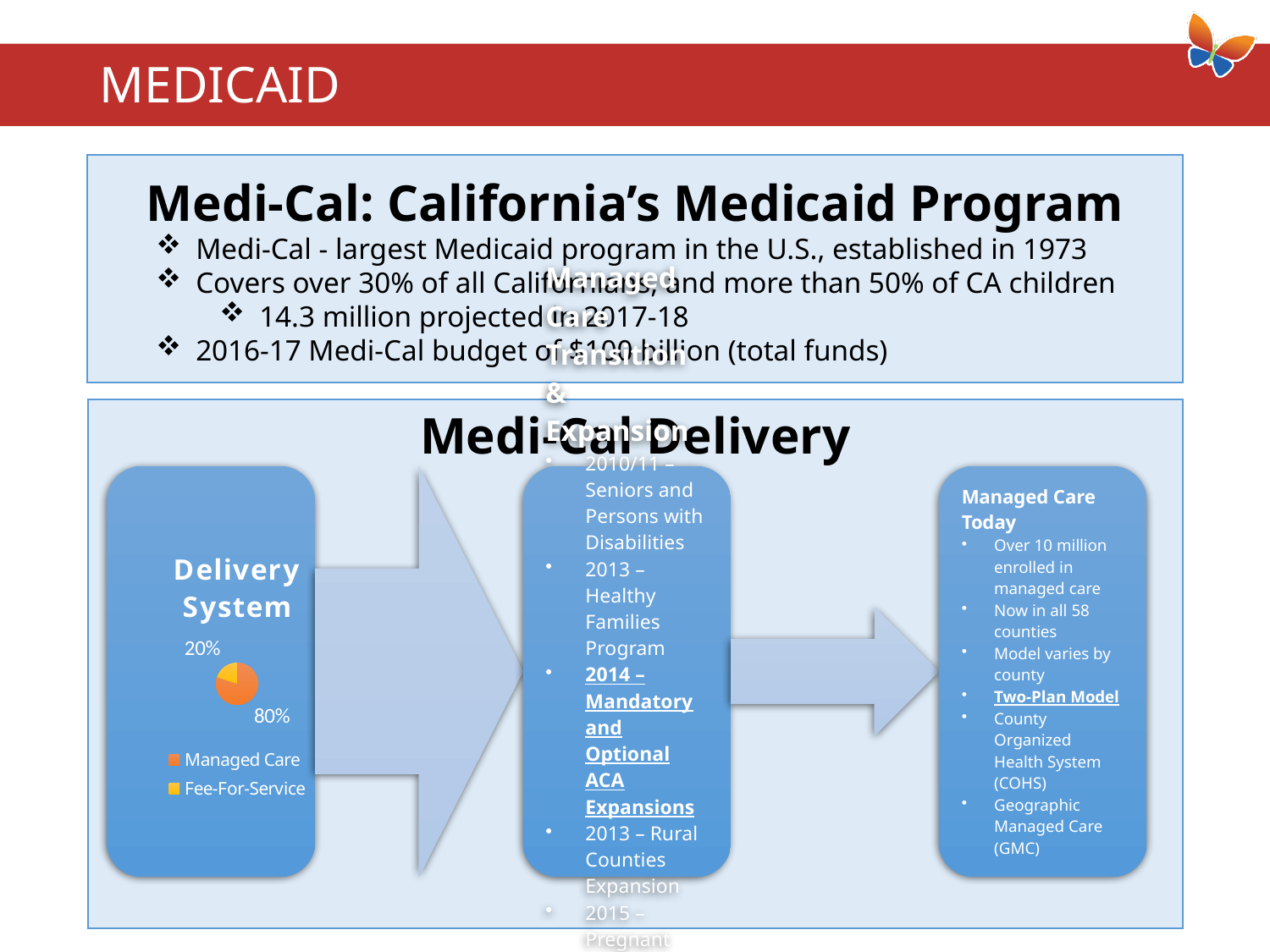
In the Delivery System pie chart, what share is Managed Care? 80% How many entries does the legend of the Delivery System pie chart list? 2 How many slices does the Delivery System pie chart have? 2 In the Delivery System pie chart, which legend entry is shown in orange? Managed Care In the Delivery System pie chart, which is larger: Managed Care or Fee-For-Service? Managed Care What kind of chart is the Delivery System chart? pie chart In the Delivery System pie chart, what share is Fee-For-Service? 20% Which slice of the Delivery System pie chart is the largest? Managed Care In the Delivery System pie chart, what is the difference in percentage points between Managed Care and Fee-For-Service? 60 What is the title of the pie chart on the slide? Delivery System Which slice of the Delivery System pie chart is the smallest? Fee-For-Service